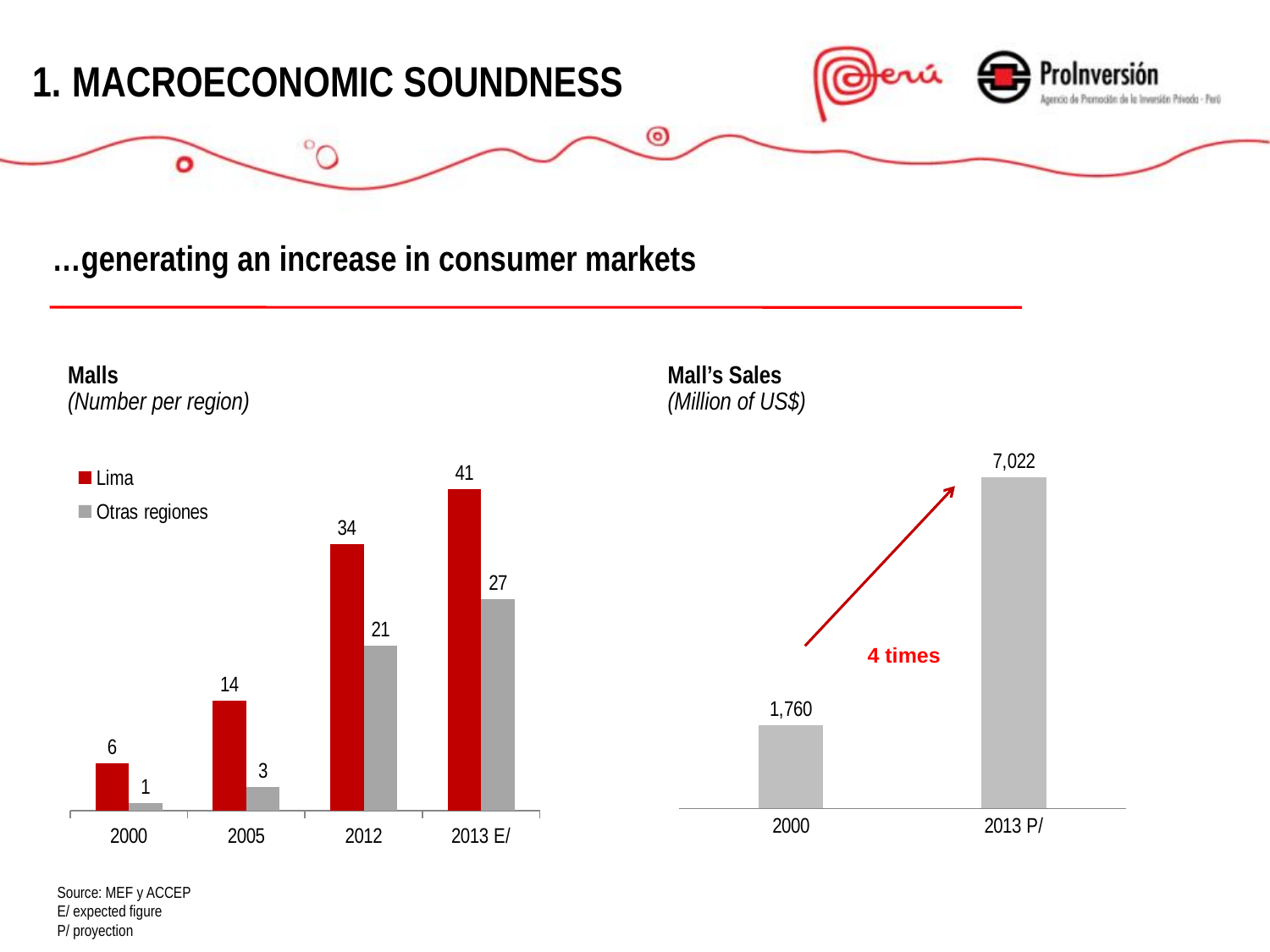
In the Malls chart, do the Lima values rise or fall from 2000 to 2013 E/? rise What kind of chart is the Mall's Sales chart? bar chart In the Malls chart, how many series does the legend list? 2 In the Malls chart, what is the difference between Lima and Otras regiones in 2013 E/? 14 In the Malls chart, how many years are shown on the x axis? 4 In the Malls chart, which year has the lowest value for Otras regiones? 2000 In the Malls chart, what is the value for Lima in 2012? 34 In the Malls chart, which is larger in 2012: Lima or Otras regiones? Lima In the Mall's Sales chart, what is the difference between 2013 P/ and 2000? 5,262 In the Mall's Sales chart, what is the value for 2013 P/? 7,022 In the Malls chart, what is the value for Otras regiones in 2005? 3 In the Malls chart, which year has the highest value for Lima? 2013 E/